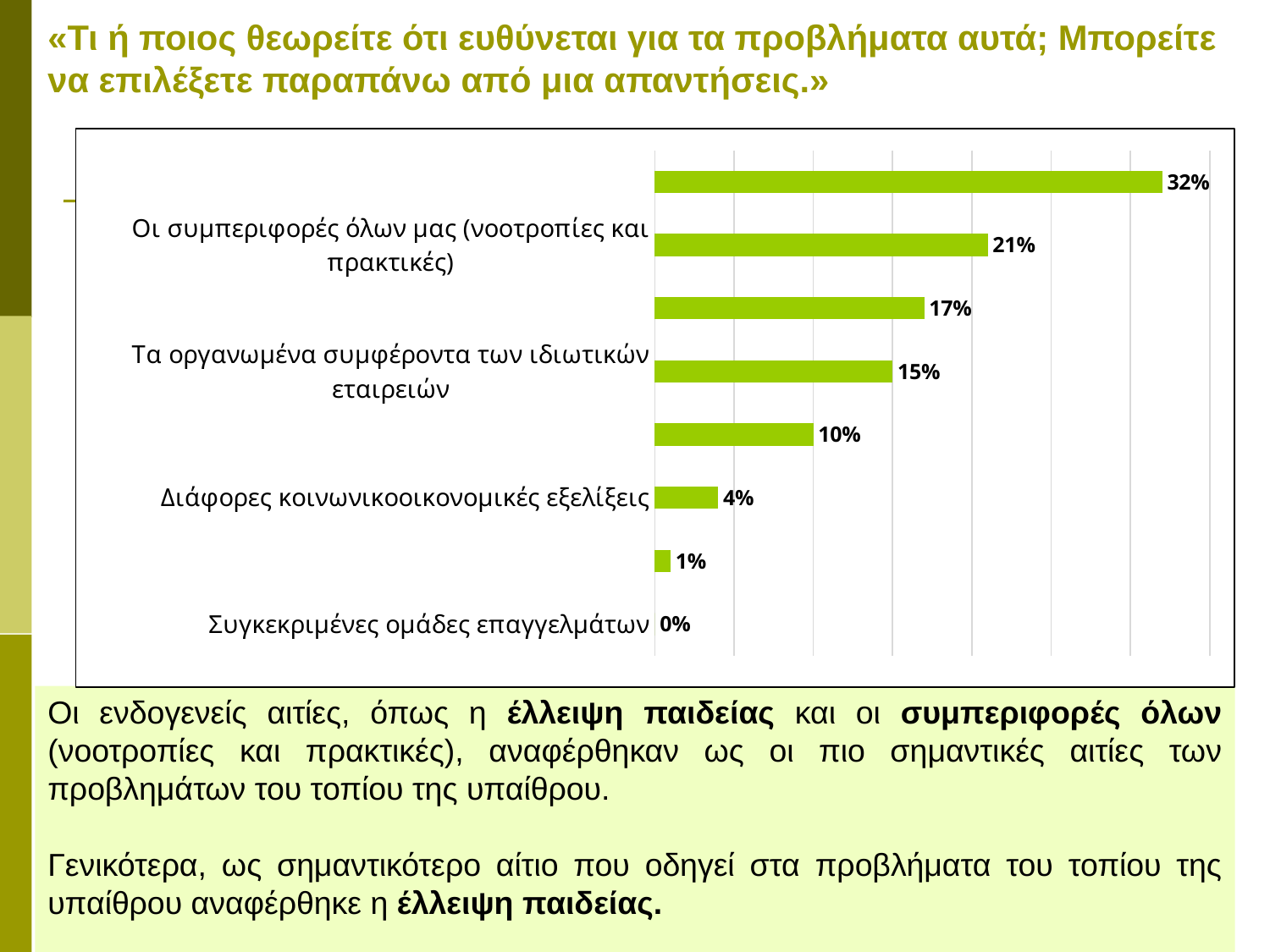
What percentage is shown for «Τα οργανωμένα συμφέροντα των ιδιωτικών εταιρειών»? 15% Which of the labelled categories has the lowest value? Συγκεκριμένες ομάδες επαγγελμάτων What kind of chart is shown on the slide? Bar chart What is the difference between the values for «Οι συμπεριφορές όλων μας (νοοτροπίες και πρακτικές)» and «Τα οργανωμένα συμφέροντα των ιδιωτικών εταιρειών»? 6% What percentage is shown for «Διάφορες κοινωνικοοικονομικές εξελίξεις»? 4% What is the difference between the highest value on the chart and the value for «Οι συμπεριφορές όλων μας (νοοτροπίες και πρακτικές)»? 11% Which has a larger value: «Τα οργανωμένα συμφέροντα των ιδιωτικών εταιρειών» or «Διάφορες κοινωνικοοικονομικές εξελίξεις»? Τα οργανωμένα συμφέροντα των ιδιωτικών εταιρειών What percentage is shown for «Οι συμπεριφορές όλων μας (νοοτροπίες και πρακτικές)»? 21% How many bars are plotted on the chart? 8 What percentage is shown for «Συγκεκριμένες ομάδες επαγγελμάτων»? 0% What is the highest percentage value shown on the chart? 32% Do the bar values increase or decrease going from the top of the chart to the bottom? Decrease